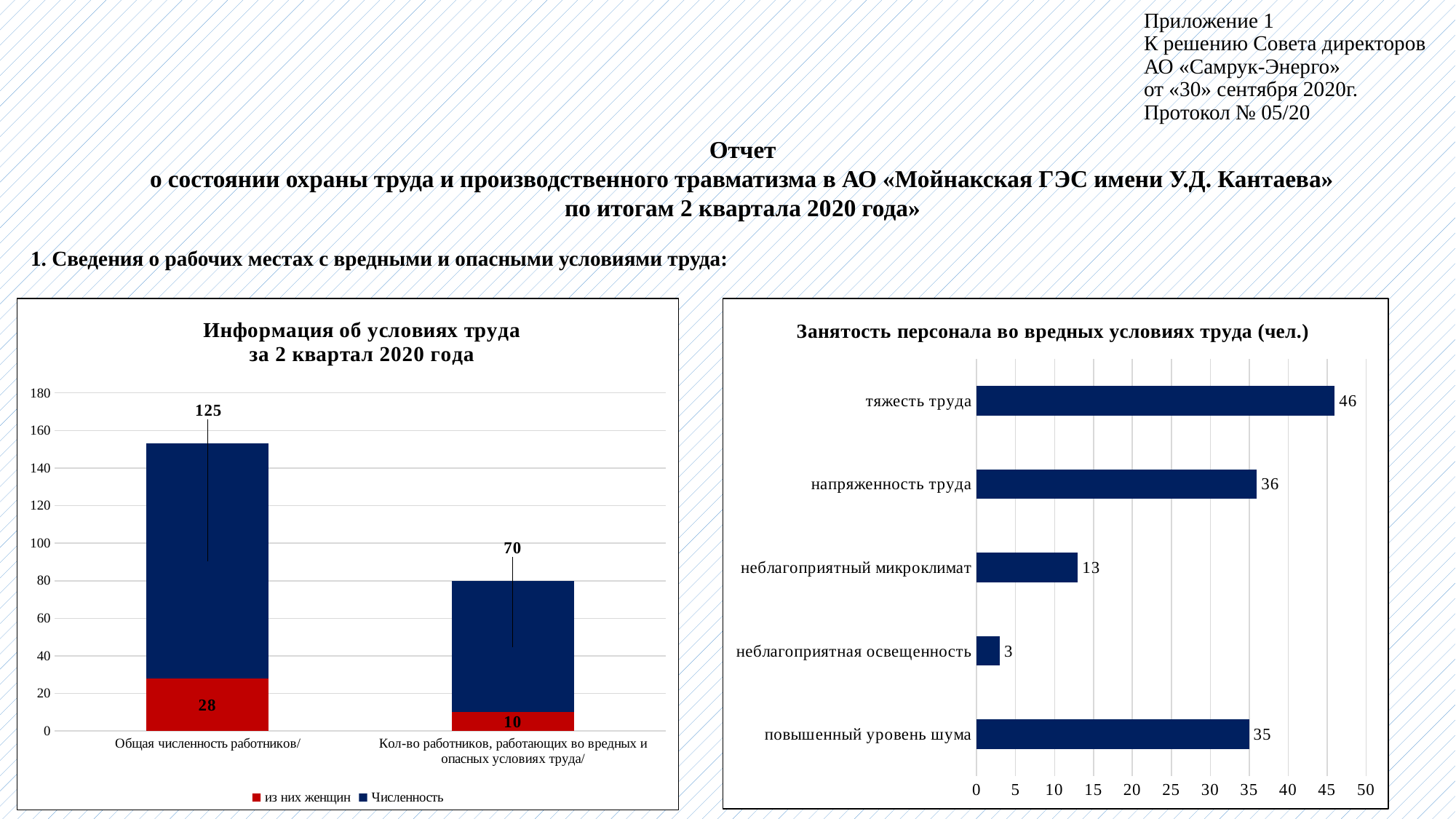
In the chart 'Занятость персонала во вредных условиях труда (чел.)', which category has the lowest value? неблагоприятная освещенность In the chart 'Занятость персонала во вредных условиях труда (чел.)', which category has the highest value? тяжесть труда In the chart 'Информация об условиях труда за 2 квартал 2020 года', what is the total of the stacked bar for 'Общая численность работников/'? 153 In the chart 'Информация об условиях труда за 2 квартал 2020 года', which category has the larger 'Численность' value? Общая численность работников/ In the chart 'Занятость персонала во вредных условиях труда (чел.)', what is the value for 'неблагоприятный микроклимат'? 13 In the chart 'Информация об условиях труда за 2 квартал 2020 года', what is the value of 'Численность' for 'Кол-во работников, работающих во вредных и опасных условиях труда/'? 70 How many series does the legend of the chart 'Информация об условиях труда за 2 квартал 2020 года' list? 2 In the chart 'Занятость персонала во вредных условиях труда (чел.)', how many categories are shown? 5 In the chart 'Занятость персонала во вредных условиях труда (чел.)', what is the difference between 'тяжесть труда' and 'напряженность труда'? 10 What kind of chart is 'Занятость персонала во вредных условиях труда (чел.)'? bar chart In the chart 'Занятость персонала во вредных условиях труда (чел.)', what is the value for 'тяжесть труда'? 46 In the chart 'Информация об условиях труда за 2 квартал 2020 года', what is the value of 'из них женщин' for 'Общая численность работников/'? 28